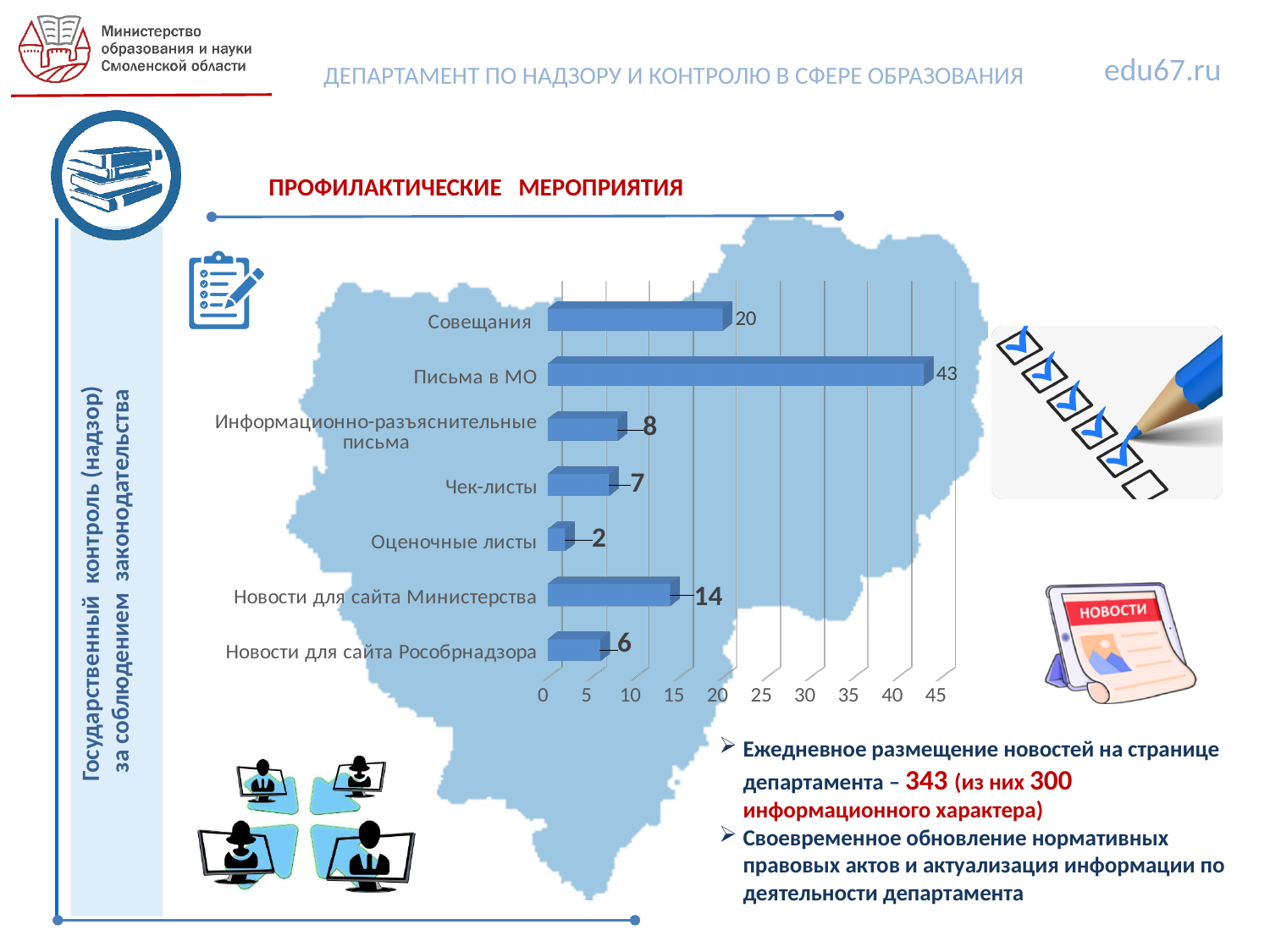
What is the value for Письма в МО? 43 What is the value for Оценочные листы? 2 Which category has the highest value? Письма в МО Is the value for Новости для сайта Министерства greater or less than 10? greater What kind of chart is shown on the slide? bar chart How many categories are shown in the chart? 7 What is the difference between the values for Информационно-разъяснительные письма and Чек-листы? 1 Which is larger, the value for Чек-листы or the value for Новости для сайта Рособрнадзора? Чек-листы What is the value for Новости для сайта Министерства? 14 What is the difference between the values for Письма в МО and Совещания? 23 Which category has the lowest value? Оценочные листы What is the value for Совещания? 20